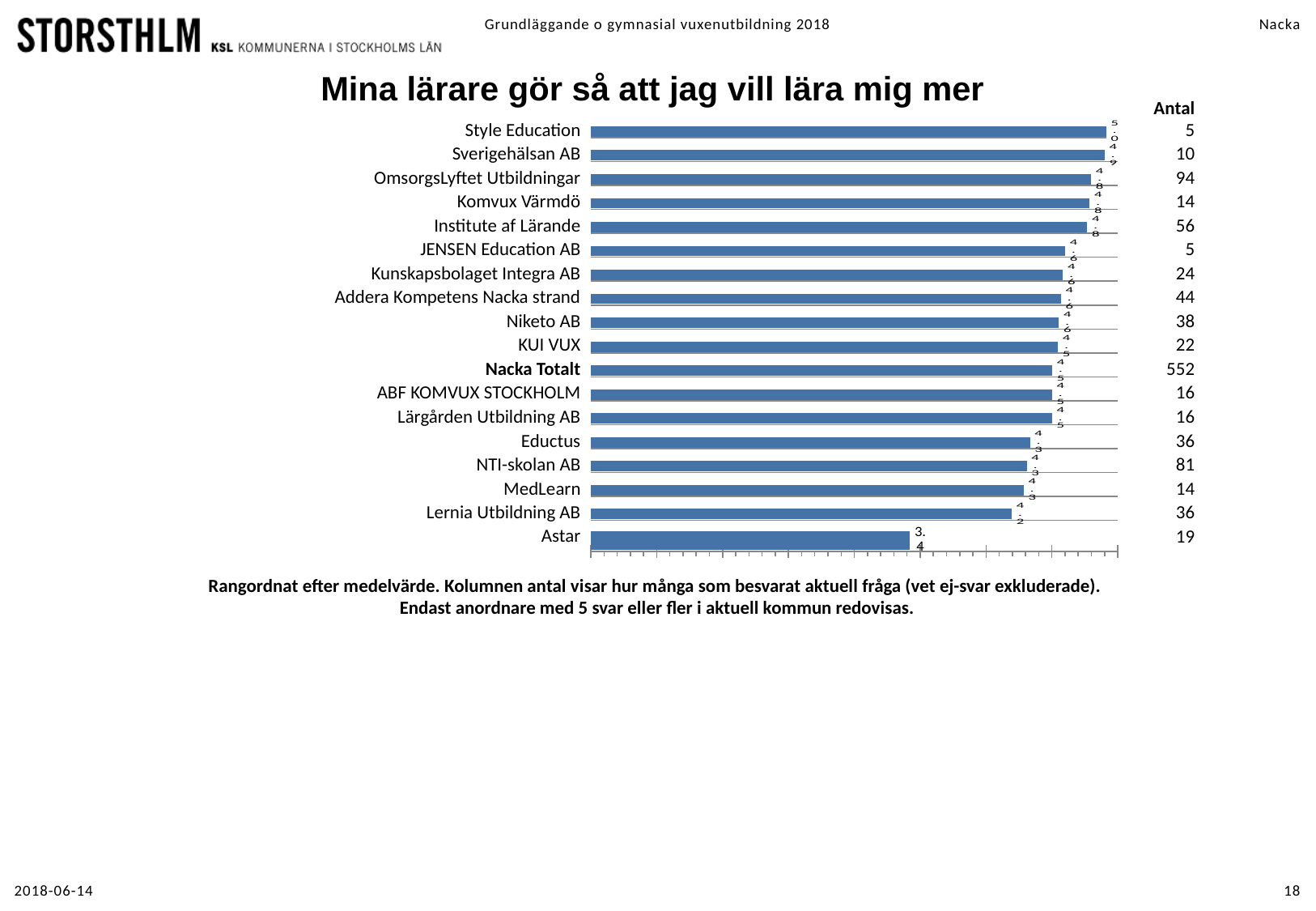
Which provider has the highest value in the chart? Style Education Which provider has the lowest value in the chart? Astar What is the value shown for Style Education? 5.0 What kind of chart is shown on the slide? bar chart What is the value shown for Nacka Totalt? 4.5 What is the value shown for Sverigehälsan AB? 4.9 How many providers (categories) are plotted in the chart? 18 What is the difference between the values for Style Education and Astar? 1.6 Which has the larger value, Lernia Utbildning AB or Astar? Lernia Utbildning AB According to the Antal column, how many respondents answered for Nacka Totalt? 552 What is the value shown for Astar? 3.4 What is the title of the chart? Mina lärare gör så att jag vill lära mig mer